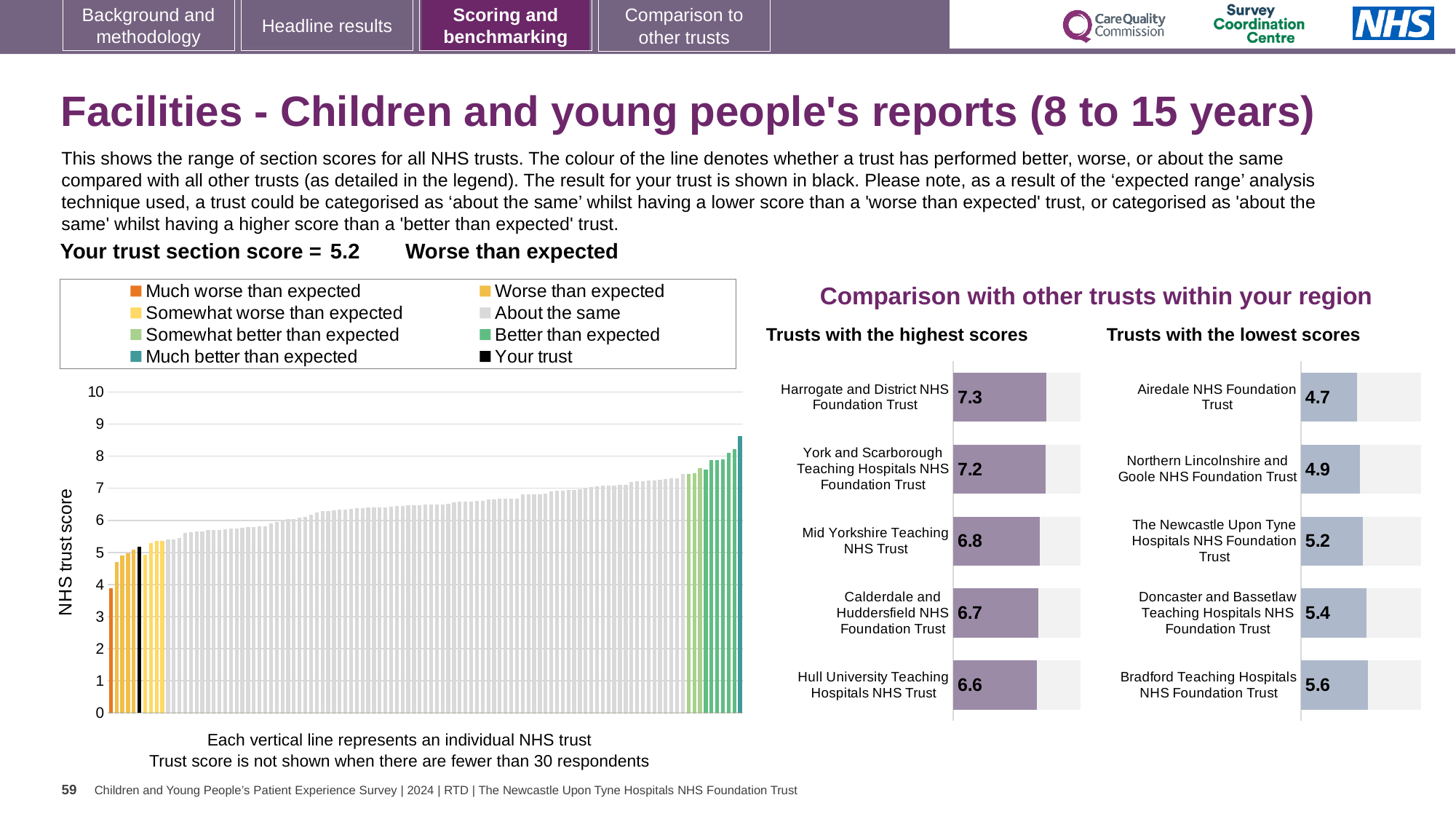
How many entries does the legend of the 'NHS trust score' chart on the left list? 8 In the 'Trusts with the highest scores' chart, which trust has the highest score? Harrogate and District NHS Foundation Trust In the 'Trusts with the highest scores' chart, what is the score for Mid Yorkshire Teaching NHS Trust? 6.8 In the 'Trusts with the lowest scores' chart, which trust has the lowest score? Airedale NHS Foundation Trust In the 'Trusts with the lowest scores' chart, what is the score for Doncaster and Bassetlaw Teaching Hospitals NHS Foundation Trust? 5.4 In the 'Trusts with the highest scores' chart, what is the difference between the scores of Harrogate and District NHS Foundation Trust and Hull University Teaching Hospitals NHS Trust? 0.7 In the 'NHS trust score' chart on the left, do the bar values rise or fall from left to right along the x axis? rise In the 'Trusts with the lowest scores' chart, what is the score for Airedale NHS Foundation Trust? 4.7 How many trusts are shown in the 'Trusts with the highest scores' chart? 5 In the 'Trusts with the lowest scores' chart, what is the difference between the scores of Bradford Teaching Hospitals NHS Foundation Trust and Airedale NHS Foundation Trust? 0.9 In the 'Trusts with the highest scores' chart, what is the score for Harrogate and District NHS Foundation Trust? 7.3 In the 'Trusts with the lowest scores' chart, which has the higher score: Northern Lincolnshire and Goole NHS Foundation Trust or The Newcastle Upon Tyne Hospitals NHS Foundation Trust? The Newcastle Upon Tyne Hospitals NHS Foundation Trust